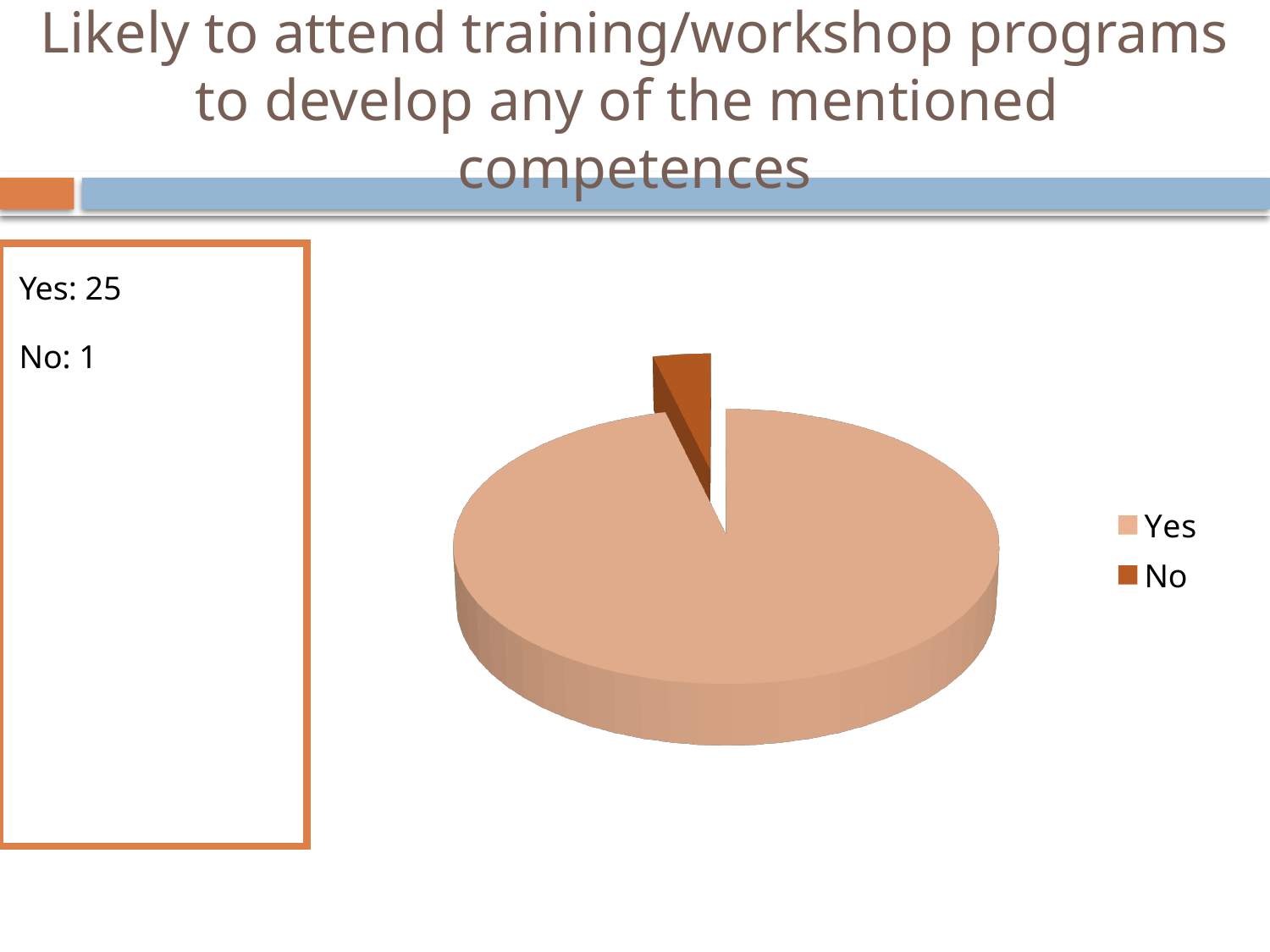
Which legend entry is shown in the darker orange colour? No What kind of chart is shown on the slide? pie chart Which slice of the pie chart is the largest? Yes What are the two legend entries of the pie chart? Yes and No According to the slide, how many respondents answered Yes? 25 What is the difference between the number of Yes and No responses shown on the slide? 24 How many entries does the legend of the pie chart list? 2 What is the total number of responses shown on the slide (Yes plus No)? 26 How many slices does the pie chart have? 2 Which is larger in the pie chart, the Yes slice or the No slice? Yes According to the slide, how many respondents answered No? 1 Which slice of the pie chart is the smallest? No